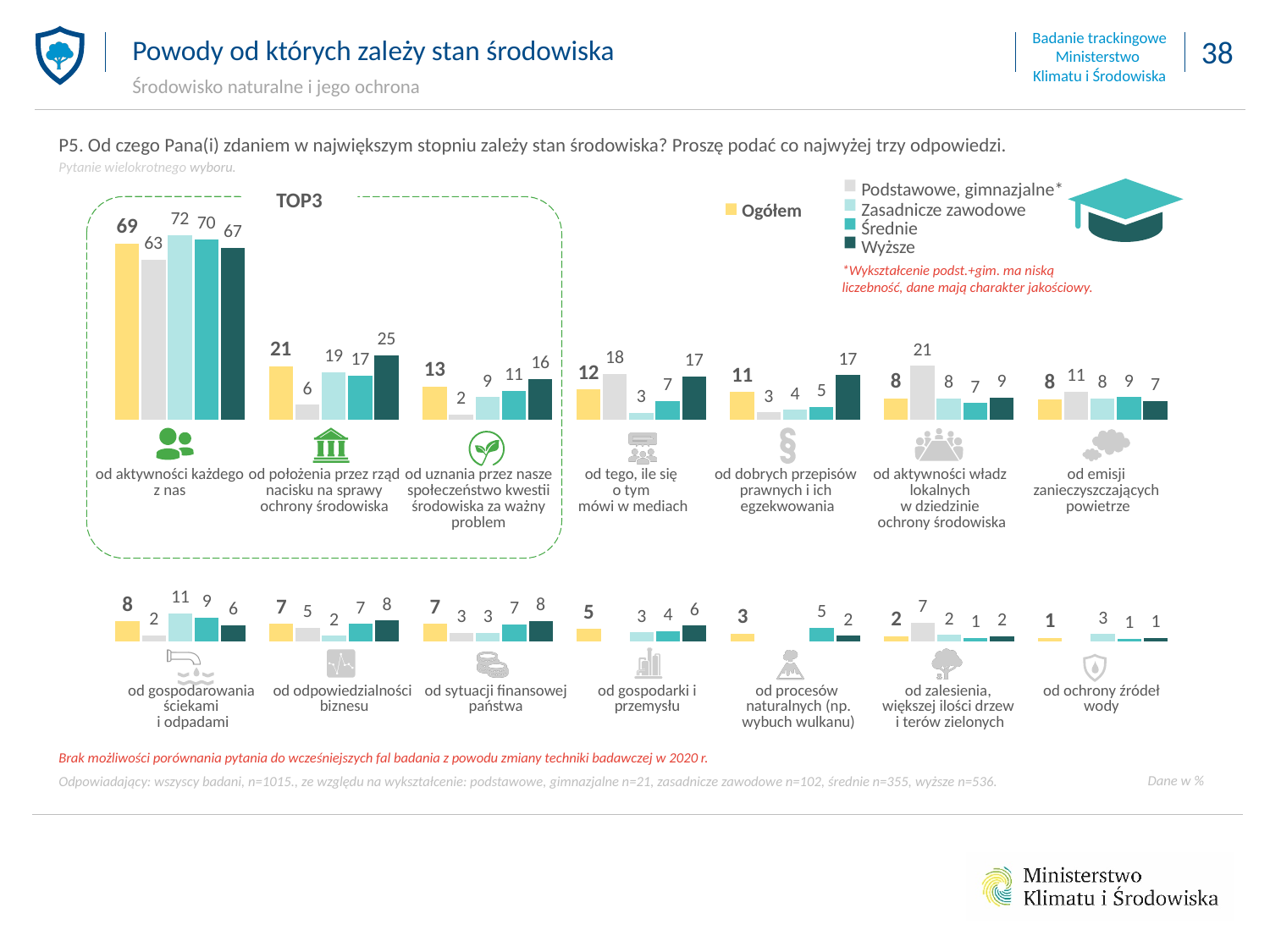
For "od tego, ile się o tym mówi w mediach", which is larger: the Podstawowe, gimnazjalne value or the Zasadnicze zawodowe value? Podstawowe, gimnazjalne How many series does the legend list? 5 What is the difference between the Wyższe and Podstawowe, gimnazjalne values for "od dobrych przepisów prawnych i ich egzekwowania"? 14 What is the Ogółem value for "od uznania przez nasze społeczeństwo kwestii środowiska za ważny problem"? 13 How many categories (reasons) are shown in the chart? 14 What is the Wyższe value for "od położenia przez rząd nacisku na sprawy ochrony środowiska"? 25 Which category has the lowest Ogółem value? od ochrony źródeł wody What is the Ogółem value for "od aktywności każdego z nas"? 69 Which category has the highest Ogółem value? od aktywności każdego z nas Which series is shown in yellow in the legend? Ogółem What is the Podstawowe, gimnazjalne value for "od aktywności władz lokalnych w dziedzinie ochrony środowiska"? 21 What kind of chart is shown on the slide? bar chart